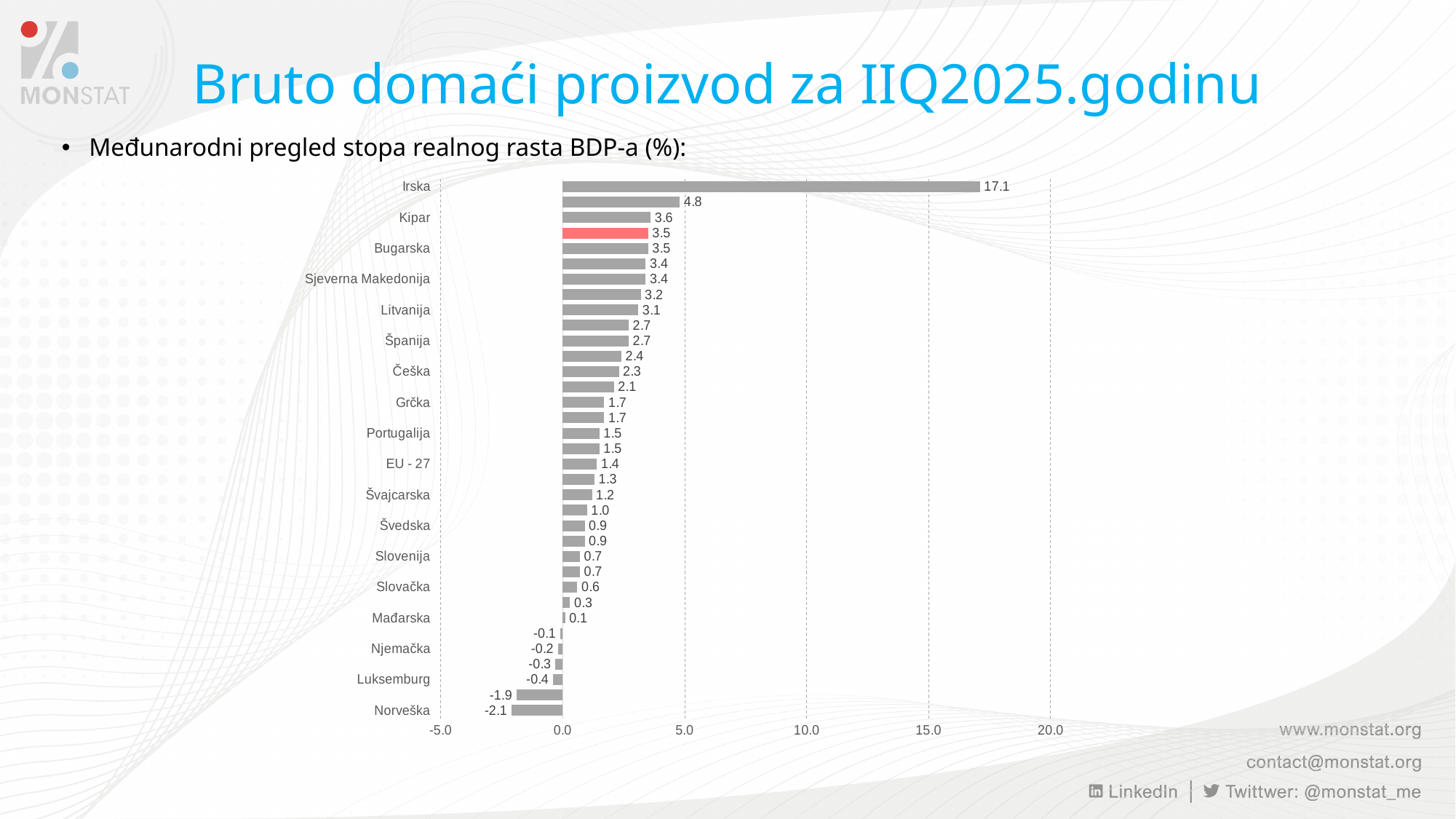
What is the difference between the values for Irska and Kipar? 13.5 Is the value for Irska greater or less than 15.0? greater What is the value for Luksemburg? -0.4 Which is larger, the value for Bugarska or the value for Litvanija? Bugarska What is the value for Irska? 17.1 What kind of chart is shown on the slide? bar chart What is the value for EU - 27? 1.4 What value is shown on the bar highlighted in red? 3.5 What is the value for Kipar? 3.6 What is the value for Norveška? -2.1 Which country has the lowest value? Norveška Which country has the highest value? Irska